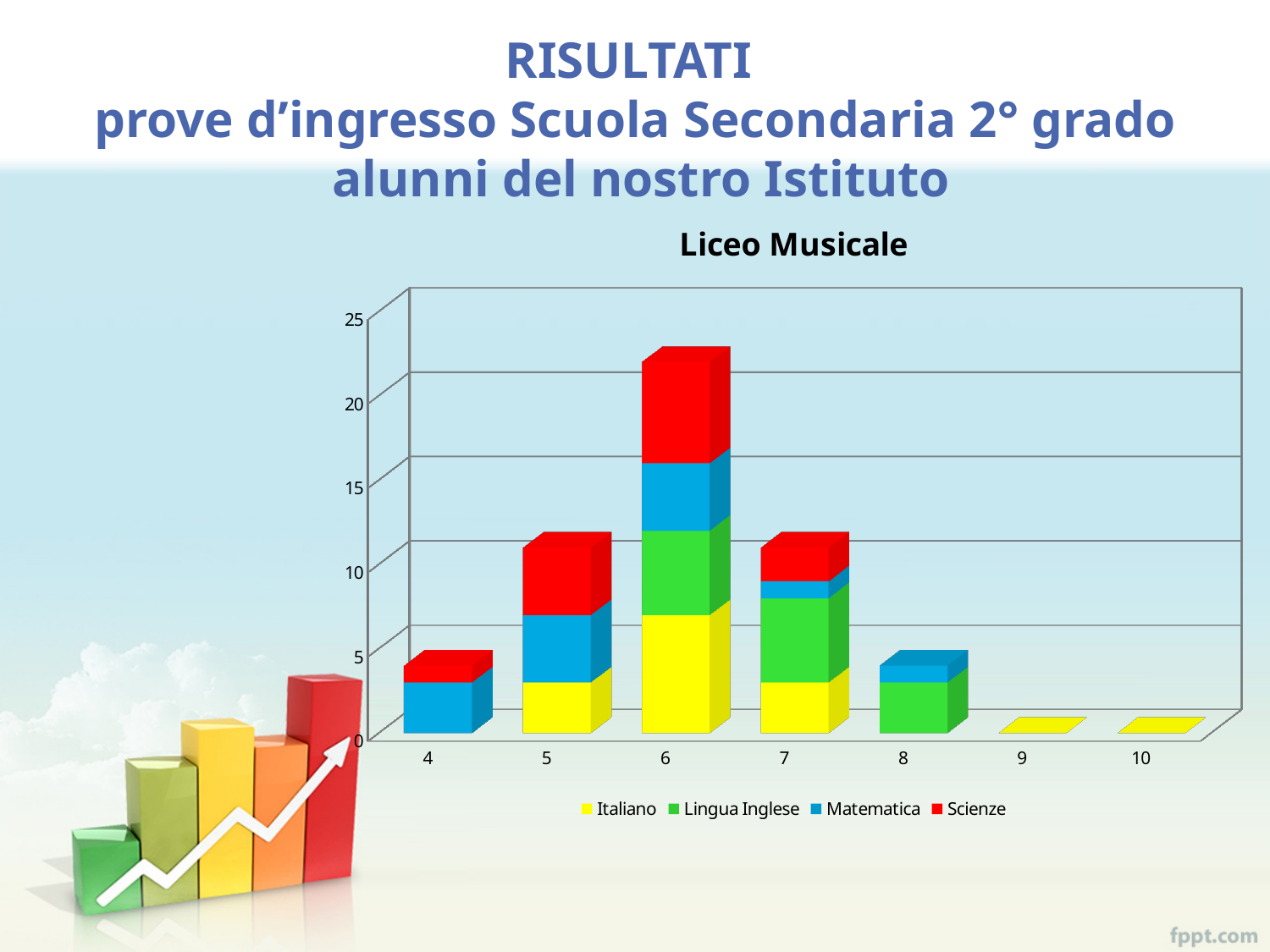
Is the stacked total for category 4 greater or less than 5? less Which colour represents the Scienze series in the legend? Red How many categories are shown on the x axis? 7 What kind of chart is shown on the slide? Stacked bar chart How many series does the legend list? 4 Do the stacked totals rise or fall from category 6 to category 8? fall What is the title of the chart? Liceo Musicale Is the stacked total for category 6 greater or less than 20? greater Which has the larger stacked total, category 6 or category 7? 6 Which has the larger stacked total, category 5 or category 4? 5 Which category has the highest stacked total? 6 Is the stacked total for category 8 greater or less than 5? less